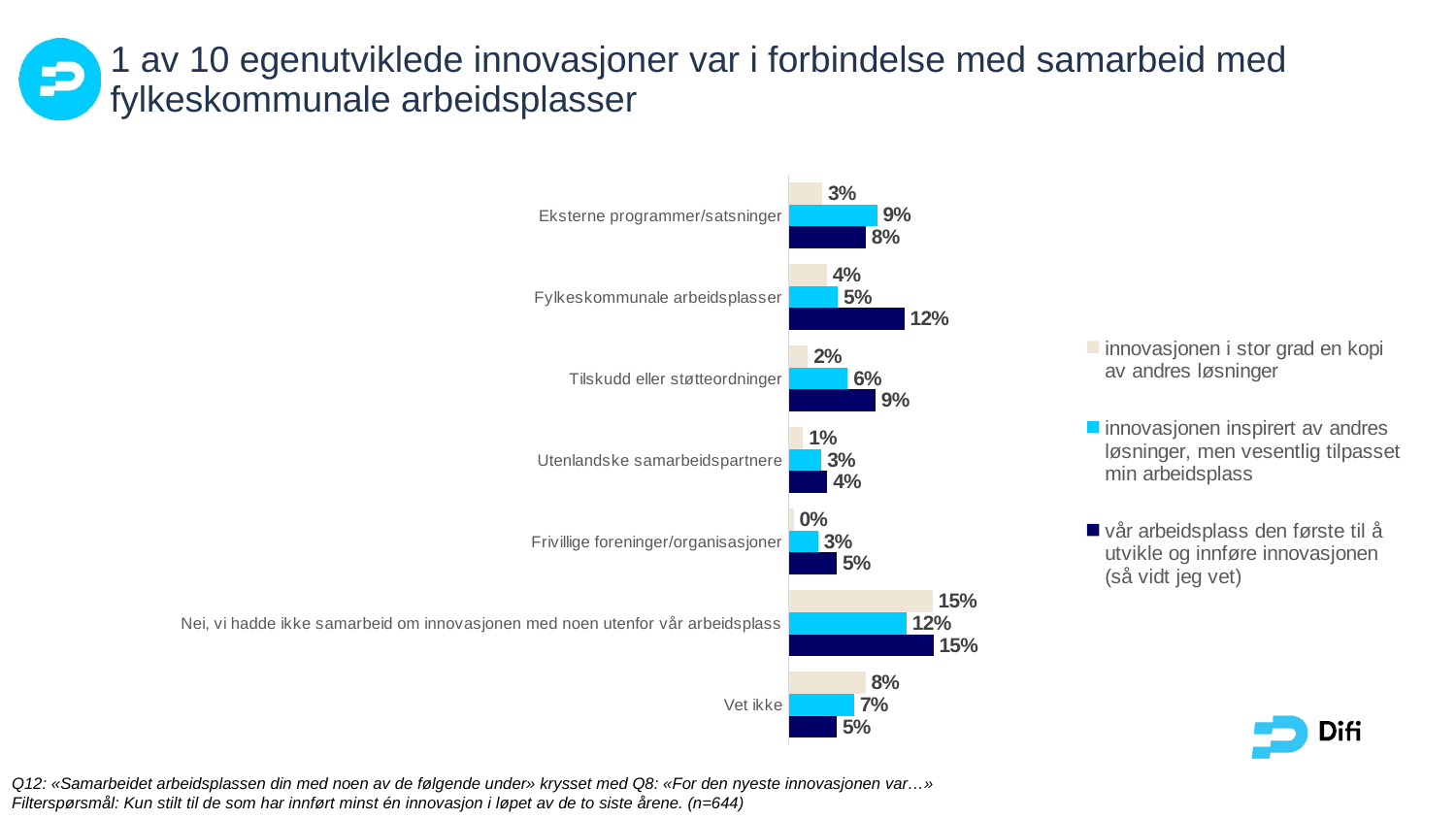
For Tilskudd eller støtteordninger, which is larger: the "innovasjonen inspirert av andres løsninger, men vesentlig tilpasset min arbeidsplass" value or the "vår arbeidsplass den første til å utvikle og innføre innovasjonen (så vidt jeg vet)" value? vår arbeidsplass den første til å utvikle og innføre innovasjonen (så vidt jeg vet) How many series does the legend list? 3 What is the value for Utenlandske samarbeidspartnere in the series "innovasjonen i stor grad en kopi av andres løsninger"? 1% Which colour represents the series "vår arbeidsplass den første til å utvikle og innføre innovasjonen (så vidt jeg vet)"? Dark blue What is the value for Vet ikke in the series "innovasjonen i stor grad en kopi av andres løsninger"? 8% What is the value for Fylkeskommunale arbeidsplasser in the series "vår arbeidsplass den første til å utvikle og innføre innovasjonen (så vidt jeg vet)"? 12% What kind of chart is shown on the slide? Bar chart Which category has the highest value in the series "innovasjonen i stor grad en kopi av andres løsninger"? Nei, vi hadde ikke samarbeid om innovasjonen med noen utenfor vår arbeidsplass Which category has the lowest value in the series "innovasjonen i stor grad en kopi av andres løsninger"? Frivillige foreninger/organisasjoner How many categories are shown on the chart? 7 What is the difference between the "vår arbeidsplass den første til å utvikle og innføre innovasjonen (så vidt jeg vet)" value and the "innovasjonen i stor grad en kopi av andres løsninger" value for Fylkeskommunale arbeidsplasser? 8% What is the value for Eksterne programmer/satsninger in the series "innovasjonen inspirert av andres løsninger, men vesentlig tilpasset min arbeidsplass"? 9%